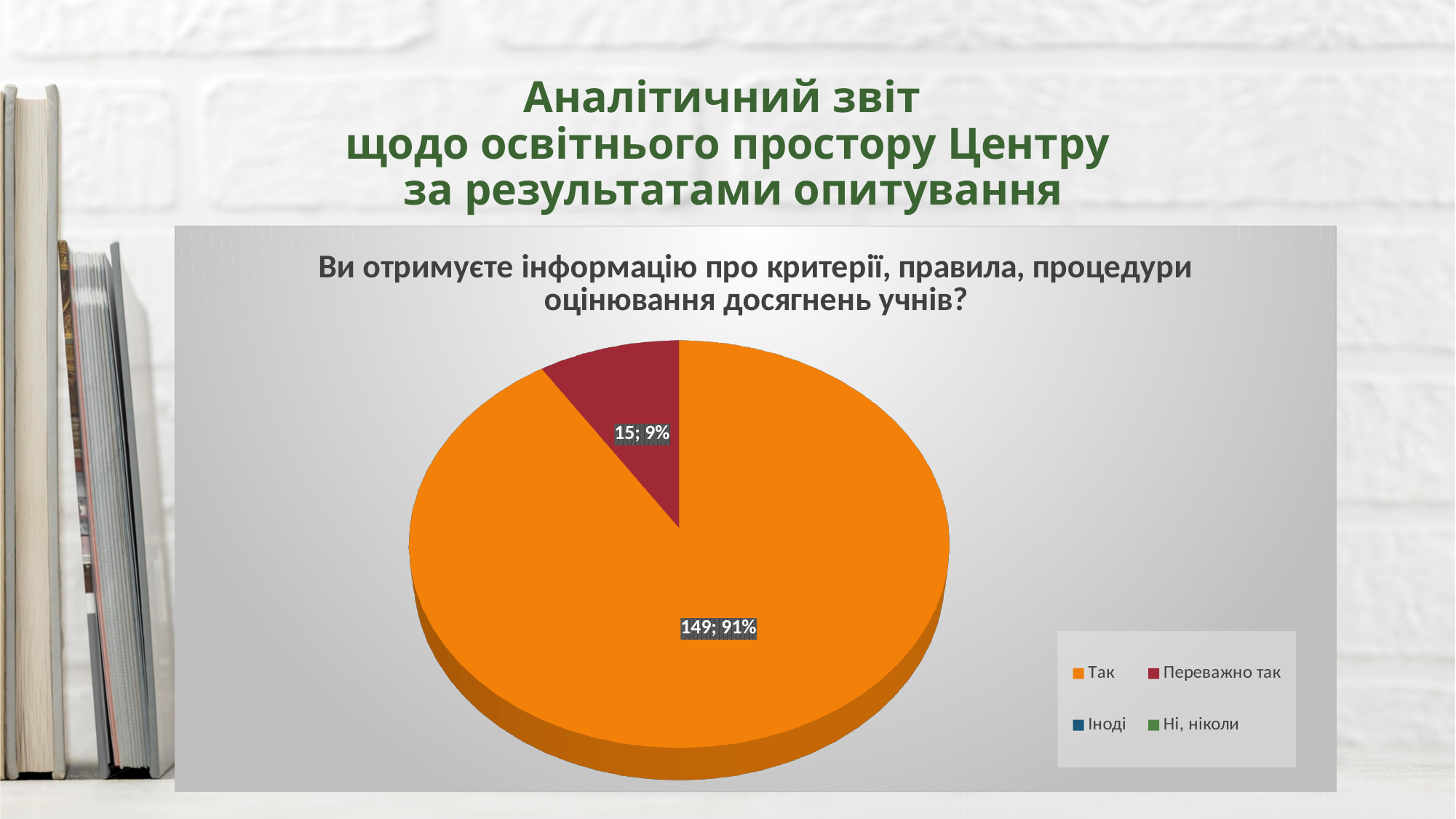
What kind of chart is shown on the slide? pie chart Which is larger, the count for "Так" or the count for "Переважно так"? Так How many answer options does the legend list? 4 What share of the pie does the "Переважно так" slice represent? 9% How many respondents answered "Так"? 149 What question is shown as the title of the chart? Ви отримуєте інформацію про критерії, правила, процедури оцінювання досягнень учнів? What colour is the "Так" slice of the pie? orange What share of the pie does the "Так" slice represent? 91% What is the difference between the number of "Так" responses and the number of "Переважно так" responses? 134 What is the total number of responses shown by the two labelled slices? 164 Which answer option has the largest slice of the pie? Так How many respondents answered "Переважно так"? 15